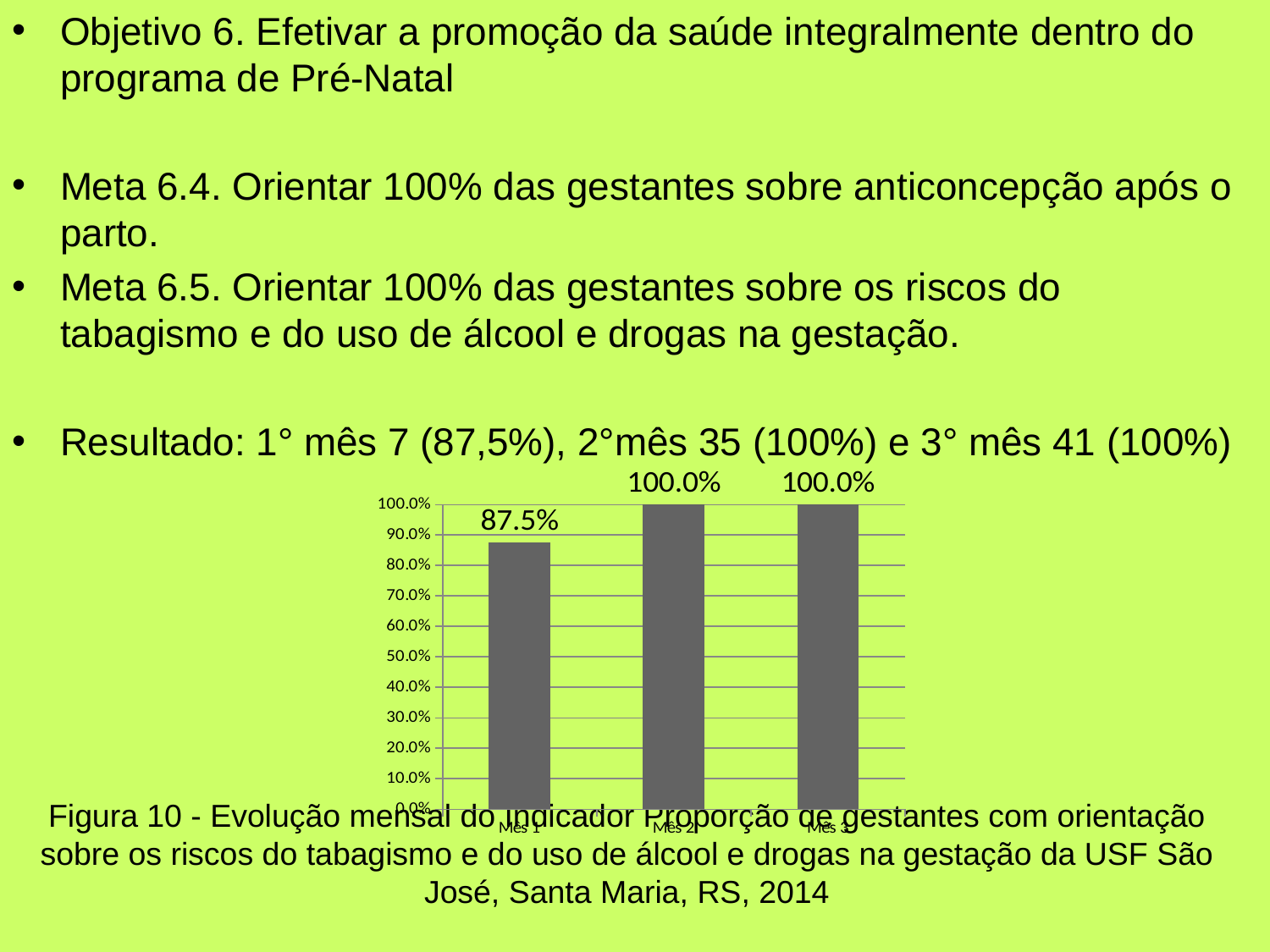
Do the values rise or fall from Mês 1 to Mês 3? rise Is the value for Mês 1 greater or less than 90.0%? less What is the value shown for Mês 2? 100.0% How many bars are plotted in the chart? 3 What is the highest tick value shown on the vertical axis? 100.0% What colour are the bars in the chart? dark grey What is the value shown for Mês 1? 87.5% What kind of chart is shown on the slide? bar chart Which is larger, the value for Mês 1 or the value for Mês 3? Mês 3 What is the value shown for Mês 3? 100.0% Which month has the lowest value in the chart? Mês 1 What is the difference between the values for Mês 2 and Mês 1? 12.5%